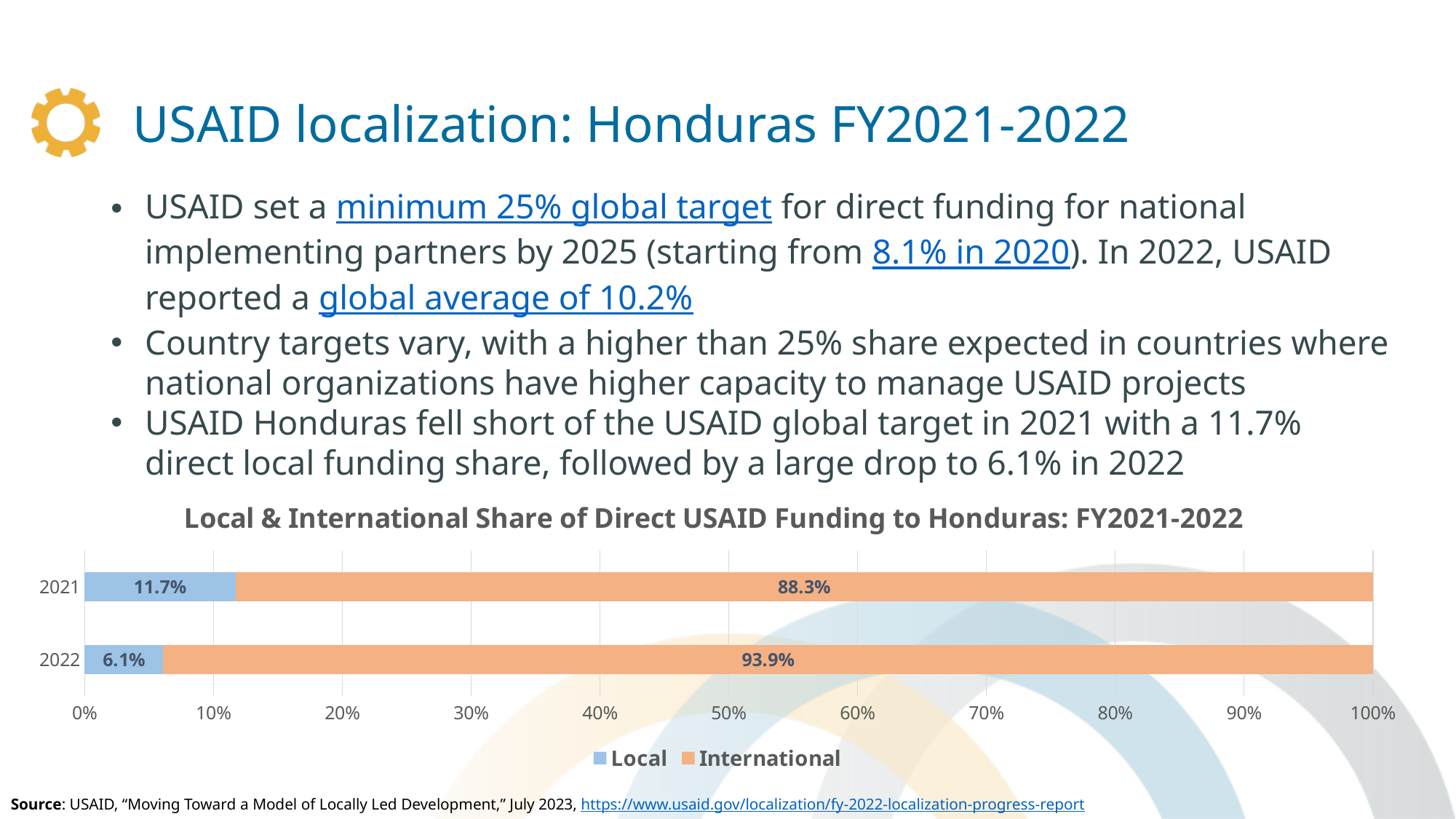
Is the Local share in 2022 larger or smaller than the Local share in 2021? smaller What is the Local share of direct USAID funding to Honduras in 2022? 6.1% By how many percentage points did the Local share fall from 2021 to 2022? 5.6 percentage points Is the Local share for 2021 greater or less than 10%? greater Which year has the lower International share of direct USAID funding to Honduras? 2021 How many series does the chart legend list? 2 What is the Local share of direct USAID funding to Honduras in 2021? 11.7% What is the International share of direct USAID funding to Honduras in 2022? 93.9% What type of chart is shown on the slide? Stacked bar chart Which year has the higher Local share of direct USAID funding to Honduras? 2021 What is the International share of direct USAID funding to Honduras in 2021? 88.3% How many years are shown on the chart? 2